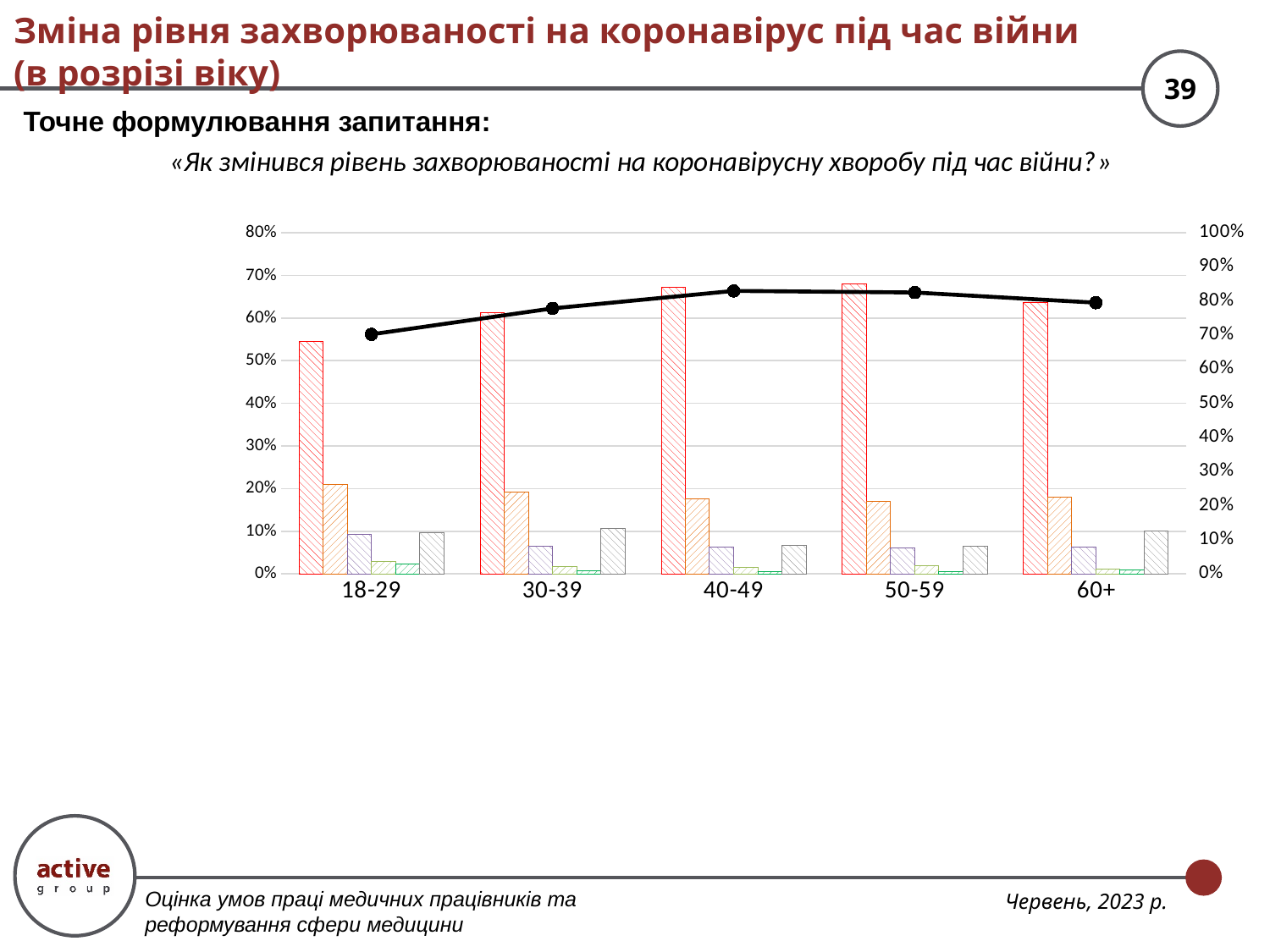
Which is larger, the first (red) bar for 18-29 or the first (red) bar for 30-39? 30-39 What is the highest value shown on the left-hand vertical axis of the chart? 80% Which age group has the lowest value for the first (red) bar in each group? 18-29 What kind of chart is shown on the slide? A bar chart combined with a line Is the second (orange) bar for the 18-29 age group greater or less than 10%? greater On the right-hand axis, is the black line's value for the 30-39 age group greater or less than 70%? greater Which age group has the lowest point on the black line? 18-29 Is the first (red) bar for the 18-29 age group greater or less than 60%? less How does the black line change from 18-29 to 60+ along the x axis? It rises up to 40-49, then falls slightly How many age groups are shown on the x axis of the chart? 5